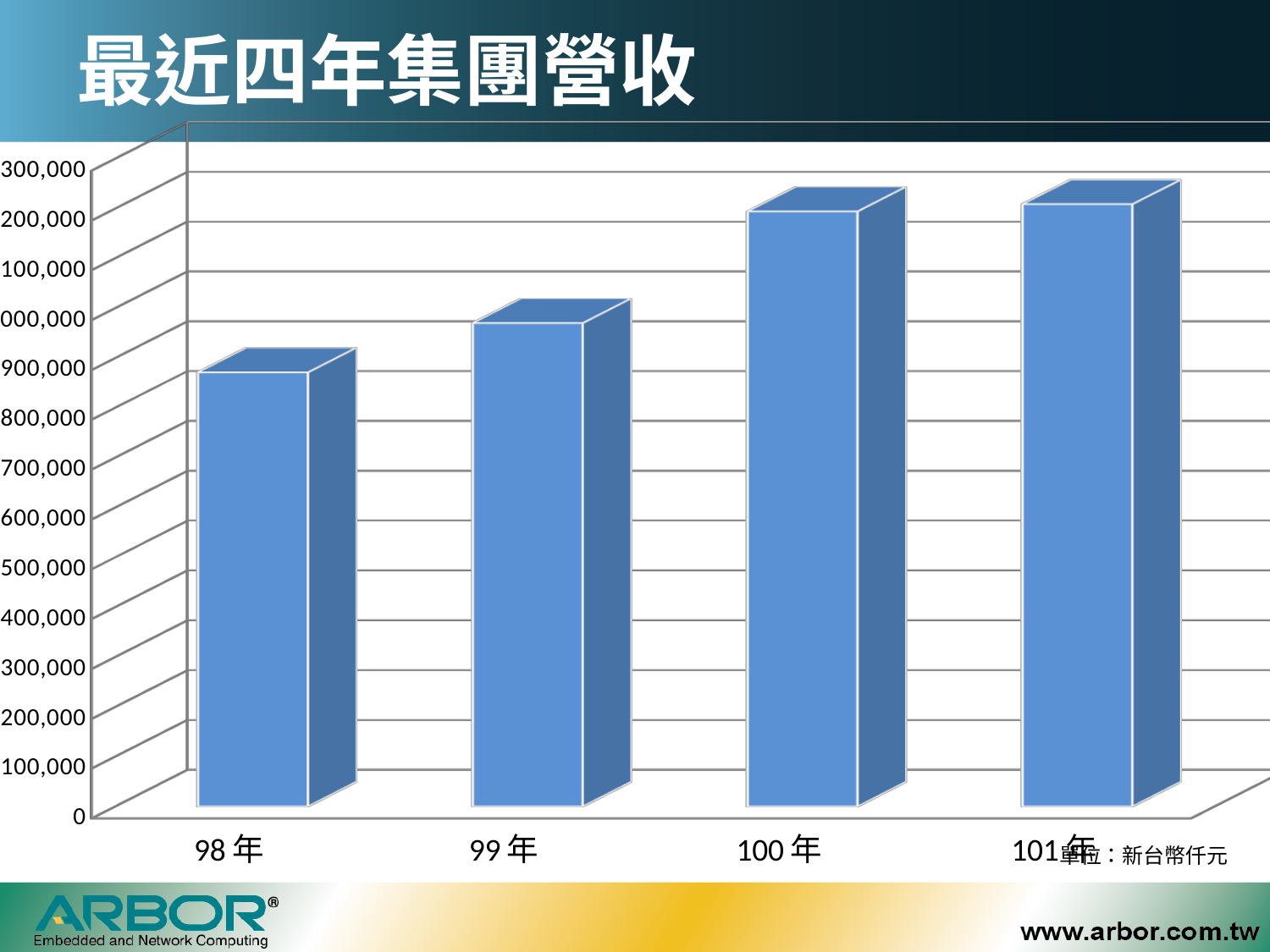
How many years (categories) are shown on the x axis? 4 What is the title of the slide/chart? 最近四年集團營收 What unit is stated for the chart values? 新台幣仟元 Is the value for 99 年 greater or less than 900,000? greater Which year has the lowest revenue? 98 年 Which is larger, the value for 98 年 or the value for 99 年? 99 年 What kind of chart is shown on the slide? bar chart Is the value for 100 年 greater or less than 1,100,000? greater Is the value for 101 年 greater or less than 1,100,000? greater Which is larger, the value for 99 年 or the value for 100 年? 100 年 Do the values generally rise or fall from 98 年 to 101 年? rise